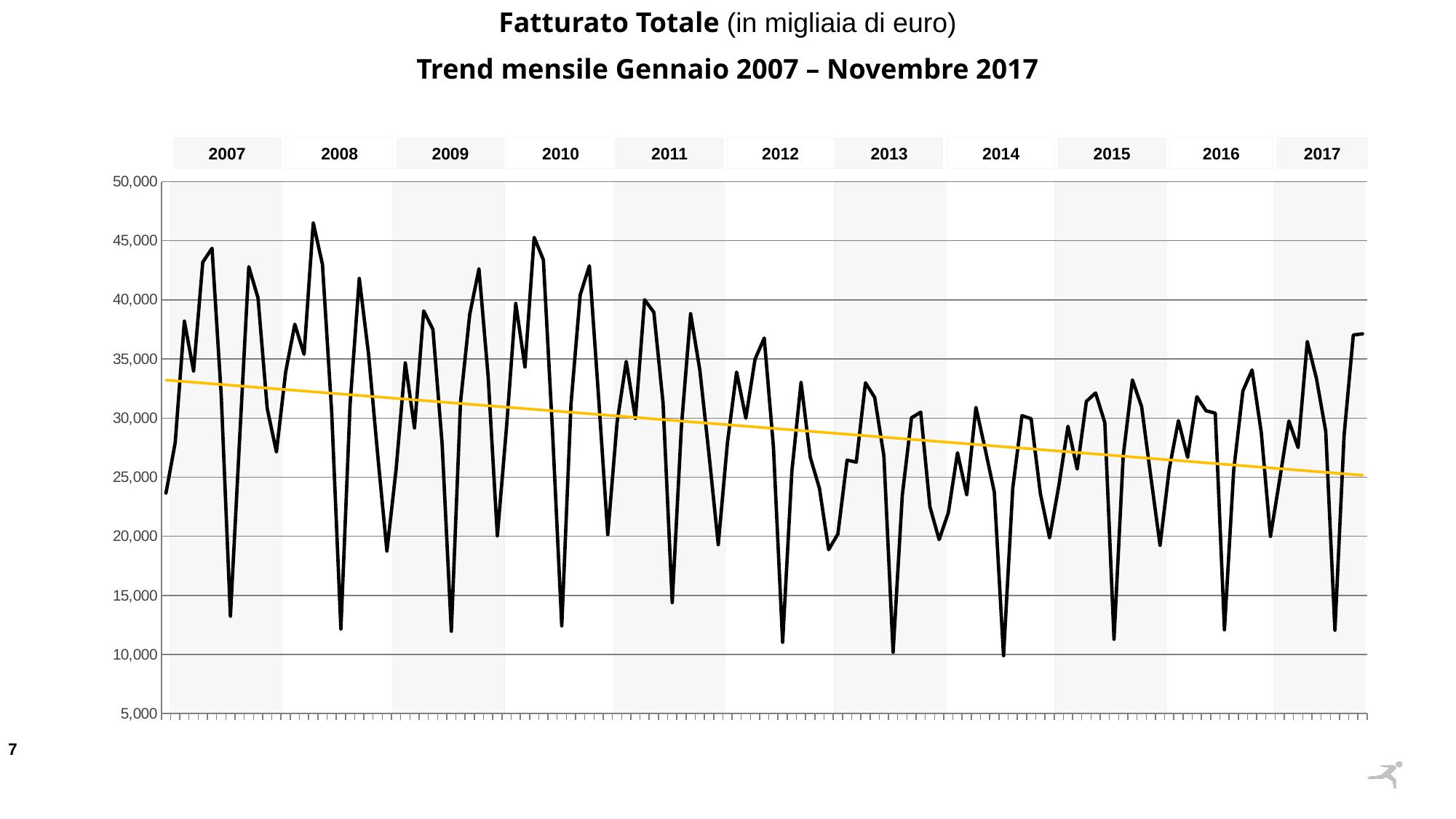
What is the title of the chart? Fatturato Totale (in migliaia di euro) – Trend mensile Gennaio 2007 – Novembre 2017 What kind of chart is shown on the slide? line chart In which year does the monthly line reach its highest peak? 2008 Which is higher: the highest peak in 2008 or the highest peak in 2015? 2008 Is the highest peak in 2008 greater or less than 45,000? greater What is the maximum value shown on the vertical axis? 50,000 Is the value of the trend line at the start of 2007 greater or less than 30,000? greater How many years are labelled along the top of the chart? 11 Is the lowest point in 2012 greater or less than 10,000? greater Does the yellow trend line rise or fall from 2007 to 2017? fall